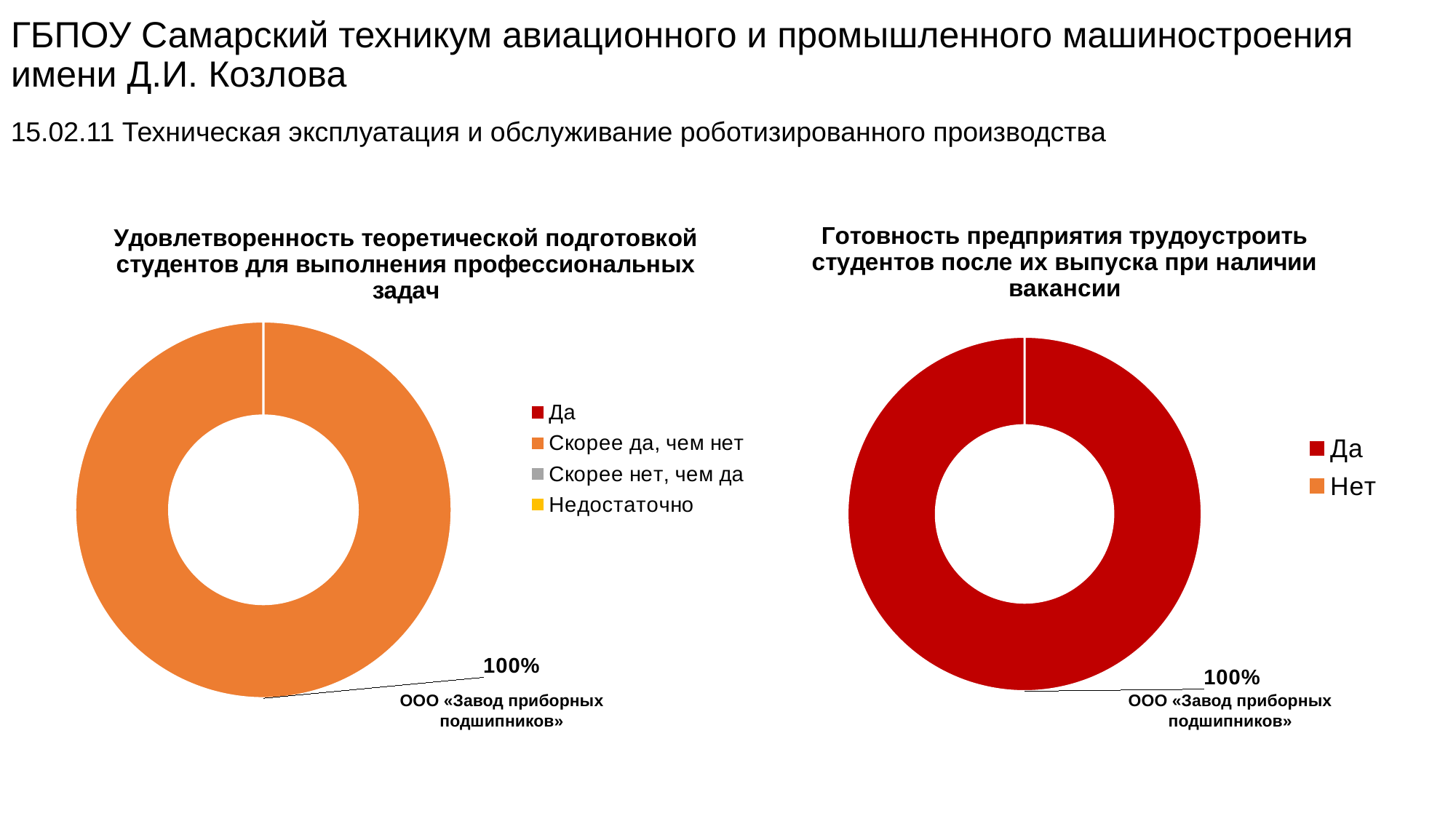
In the left chart «Удовлетворенность теоретической подготовкой студентов...», which legend category does the single filled slice correspond to? Скорее да, чем нет In the right chart «Готовность предприятия трудоустроить студентов...», what share of the doughnut does the «Да» slice take? 100% In the left chart «Удовлетворенность теоретической подготовкой студентов...», what share of the doughnut does the «Скорее да, чем нет» slice take? 100% How many entries does the legend of the right chart «Готовность предприятия трудоустроить студентов...» list? 2 How many entries does the legend of the left chart «Удовлетворенность теоретической подготовкой студентов...» list? 4 In the left chart «Удовлетворенность теоретической подготовкой студентов...», what value is shown for ООО «Завод приборных подшипников»? 100% What kind of chart is the left chart titled «Удовлетворенность теоретической подготовкой студентов для выполнения профессиональных задач»? Doughnut (pie) chart How many data labels are shown on the right chart «Готовность предприятия трудоустроить студентов...»? 1 In the right chart «Готовность предприятия трудоустроить студентов...», what value is shown for ООО «Завод приборных подшипников»? 100% What kind of chart is the right chart titled «Готовность предприятия трудоустроить студентов после их выпуска при наличии вакансии»? Doughnut (pie) chart In the right chart «Готовность предприятия трудоустроить студентов...», which legend category does the single filled slice correspond to? Да Is the value for ООО «Завод приборных подшипников» in the left chart greater or less than 50%? greater